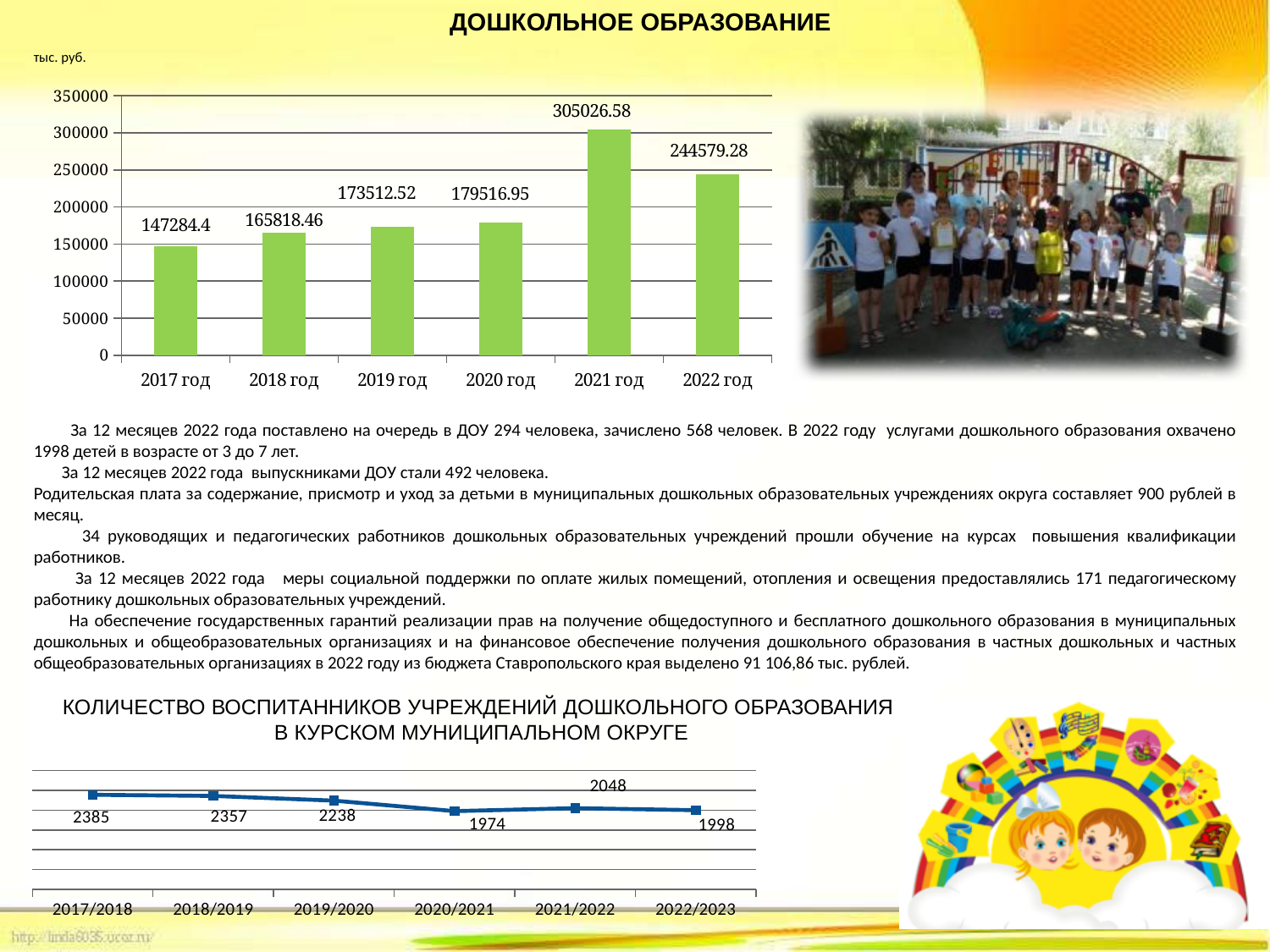
In the top bar chart (тыс. руб.), how many years are shown? 6 In the top bar chart (тыс. руб.), what is the value for 2017 год? 147284.4 In the bottom chart 'КОЛИЧЕСТВО ВОСПИТАННИКОВ УЧРЕЖДЕНИЙ ДОШКОЛЬНОГО ОБРАЗОВАНИЯ В КУРСКОМ МУНИЦИПАЛЬНОМ ОКРУГЕ', which period has the highest value? 2017/2018 What kind of chart is the top chart (тыс. руб.)? bar chart In the bottom chart 'КОЛИЧЕСТВО ВОСПИТАННИКОВ УЧРЕЖДЕНИЙ ДОШКОЛЬНОГО ОБРАЗОВАНИЯ В КУРСКОМ МУНИЦИПАЛЬНОМ ОКРУГЕ', what is the difference between the values for 2017/2018 and 2022/2023? 387 What kind of chart is the bottom chart 'КОЛИЧЕСТВО ВОСПИТАННИКОВ УЧРЕЖДЕНИЙ ДОШКОЛЬНОГО ОБРАЗОВАНИЯ В КУРСКОМ МУНИЦИПАЛЬНОМ ОКРУГЕ'? line chart In the top bar chart (тыс. руб.), which year has the highest value? 2021 год In the top bar chart (тыс. руб.), what is the value for 2021 год? 305026.58 In the top bar chart (тыс. руб.), which year has the lowest value? 2017 год In the top bar chart (тыс. руб.), what is the difference between the values for 2021 год and 2022 год? 60447.3 In the bottom chart 'КОЛИЧЕСТВО ВОСПИТАННИКОВ УЧРЕЖДЕНИЙ ДОШКОЛЬНОГО ОБРАЗОВАНИЯ В КУРСКОМ МУНИЦИПАЛЬНОМ ОКРУГЕ', what is the value for 2020/2021? 1974 In the top bar chart (тыс. руб.), which is larger: the value for 2019 год or 2020 год? 2020 год